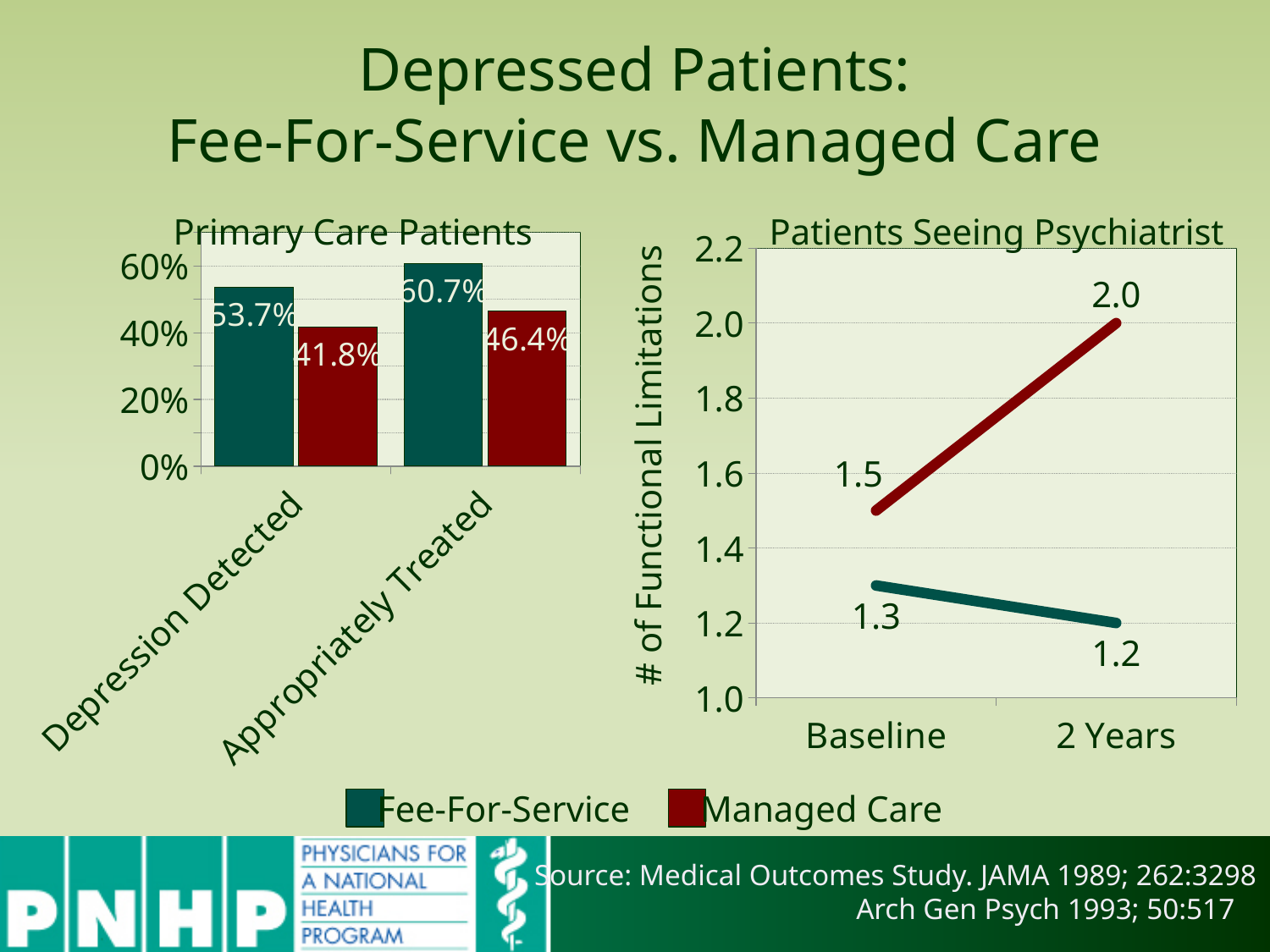
In the Patients Seeing Psychiatrist chart, by how much does the Managed Care value change from Baseline to 2 Years? 0.5 In the Patients Seeing Psychiatrist chart, what is the Managed Care value at 2 Years? 2.0 How many series does the legend list? 2 In the Primary Care Patients chart, what is the difference between the Fee-For-Service and Managed Care values for Depression Detected? 11.9% In the Patients Seeing Psychiatrist chart, what is the Fee-For-Service value at Baseline? 1.3 In the Primary Care Patients chart, which is larger for Appropriately Treated: Fee-For-Service or Managed Care? Fee-For-Service What kind of chart is the Primary Care Patients chart? Bar chart In the Primary Care Patients chart, what is the Managed Care value for Appropriately Treated? 46.4% In the Primary Care Patients chart, what is the Fee-For-Service value for Depression Detected? 53.7% In the Primary Care Patients chart, which bar has the lowest value? Managed Care, Depression Detected (41.8%) In the Patients Seeing Psychiatrist chart, does the Managed Care line rise or fall from Baseline to 2 Years? Rises What is the y-axis label of the Patients Seeing Psychiatrist chart? # of Functional Limitations